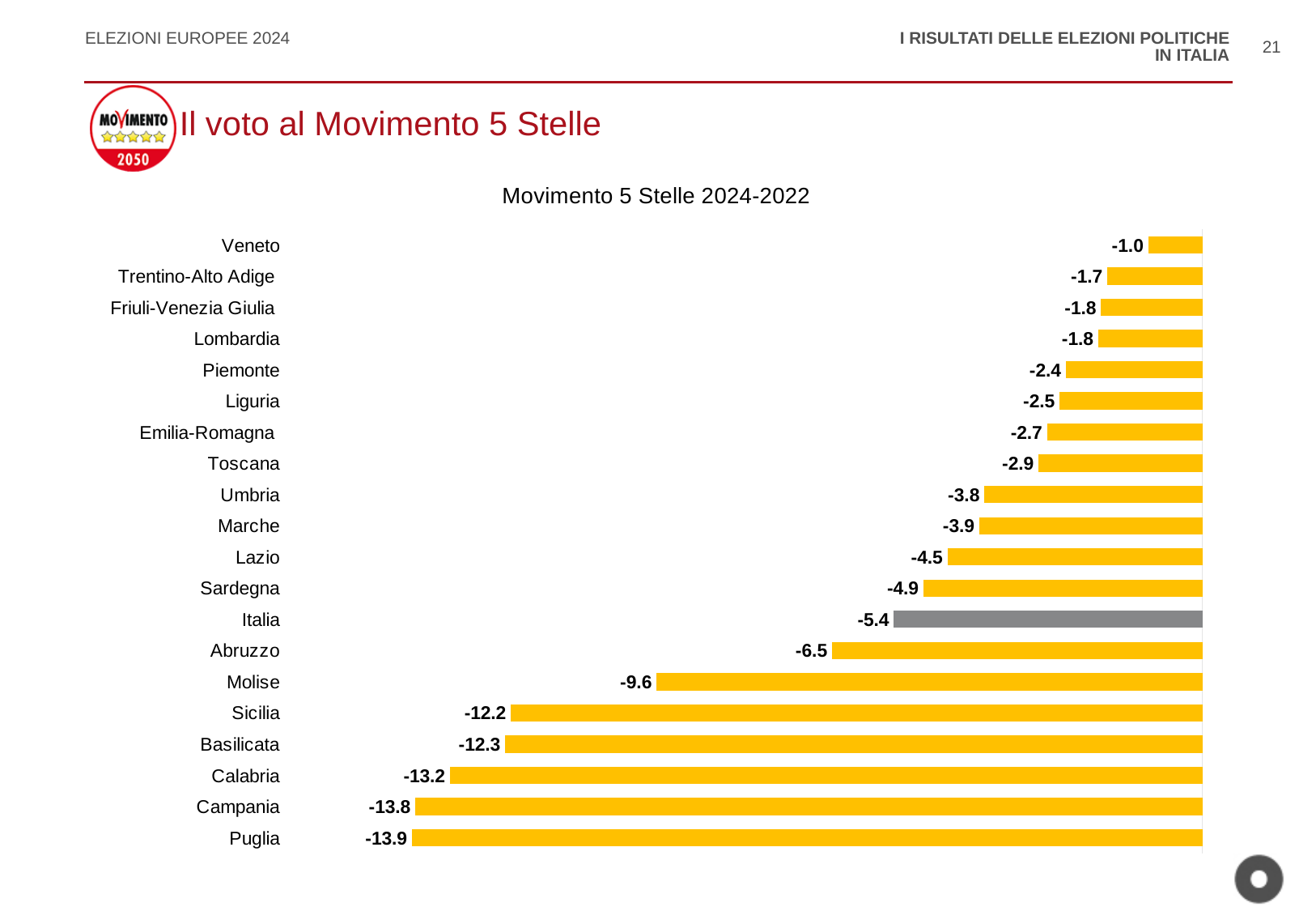
Which has the larger value, Toscana or Sicilia? Toscana Which category has the highest value? Veneto What is the value for Molise? -9.6 What is the difference between the values for Puglia and Veneto? 12.9 What kind of chart is shown on the slide? Bar chart How many categories are shown in the chart? 20 What is the title of the chart? Movimento 5 Stelle 2024-2022 What is the value for Veneto? -1.0 What is the value for Italia? -5.4 Which category has the lowest value? Puglia What is the difference between the values for Italia and Abruzzo? 1.1 What is the value for Sardegna? -4.9